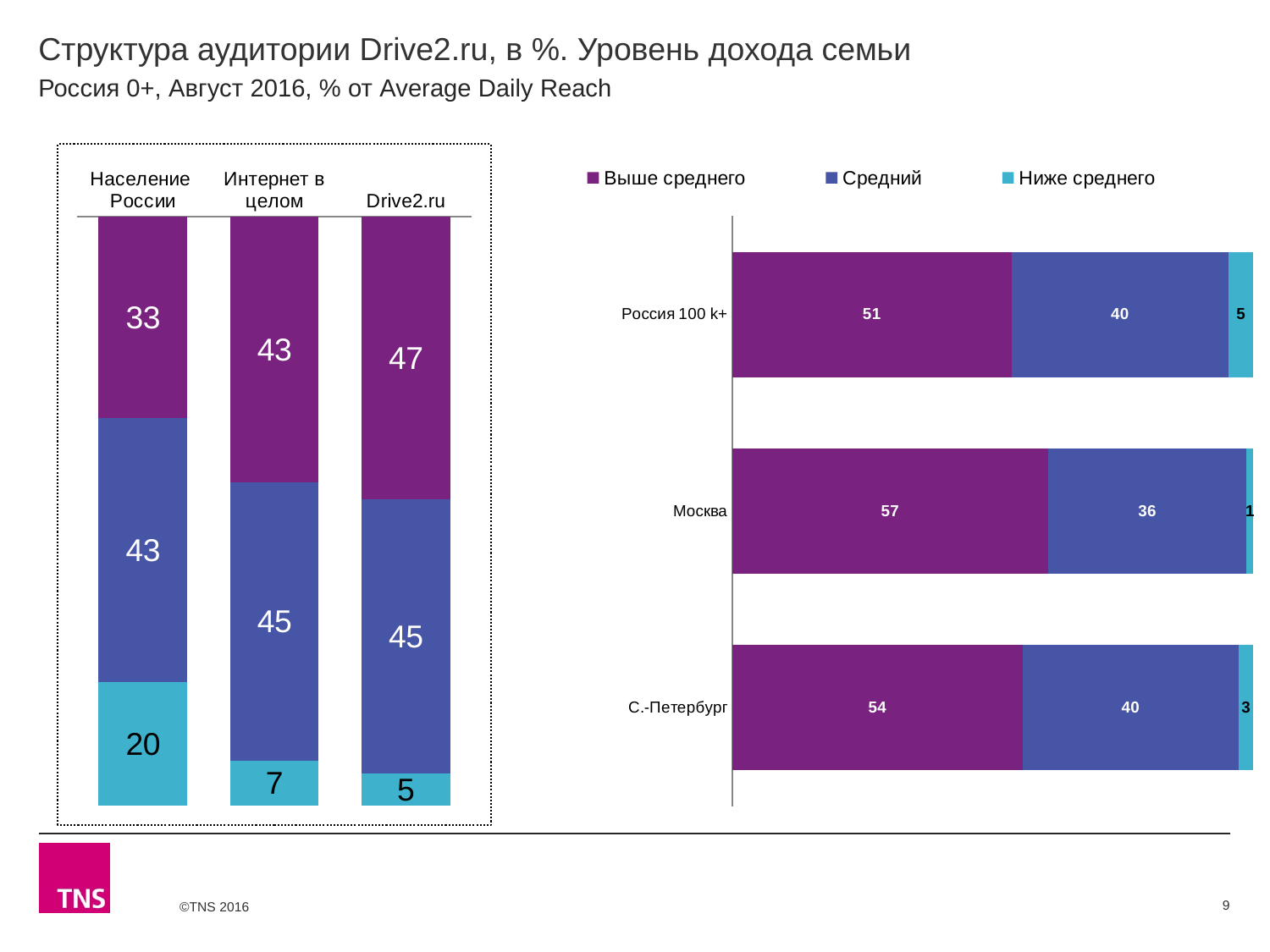
In the right chart, which category has the highest value for Выше среднего? Москва In the right chart, what is the value of Выше среднего for Москва? 57 In the left chart, how many categories are shown? 3 In the left chart, what is the value of the top (purple) segment for Drive2.ru? 47 In the left chart, which category has the smallest bottom (light blue) segment? Drive2.ru In the right chart, is the Средний value for Россия 100 k+ larger or smaller than for Москва? larger In the right chart, how many series does the legend list? 3 What type of chart is the right chart? Stacked bar chart In the left chart, what is the value of the middle (blue) segment for Интернет в целом? 45 In the left chart, what is the value of the bottom (light blue) segment for Население России? 20 In the right chart, what is the value of Ниже среднего for С.-Петербург? 3 In the left chart, what is the difference between the top (purple) segment for Drive2.ru and for Население России? 14